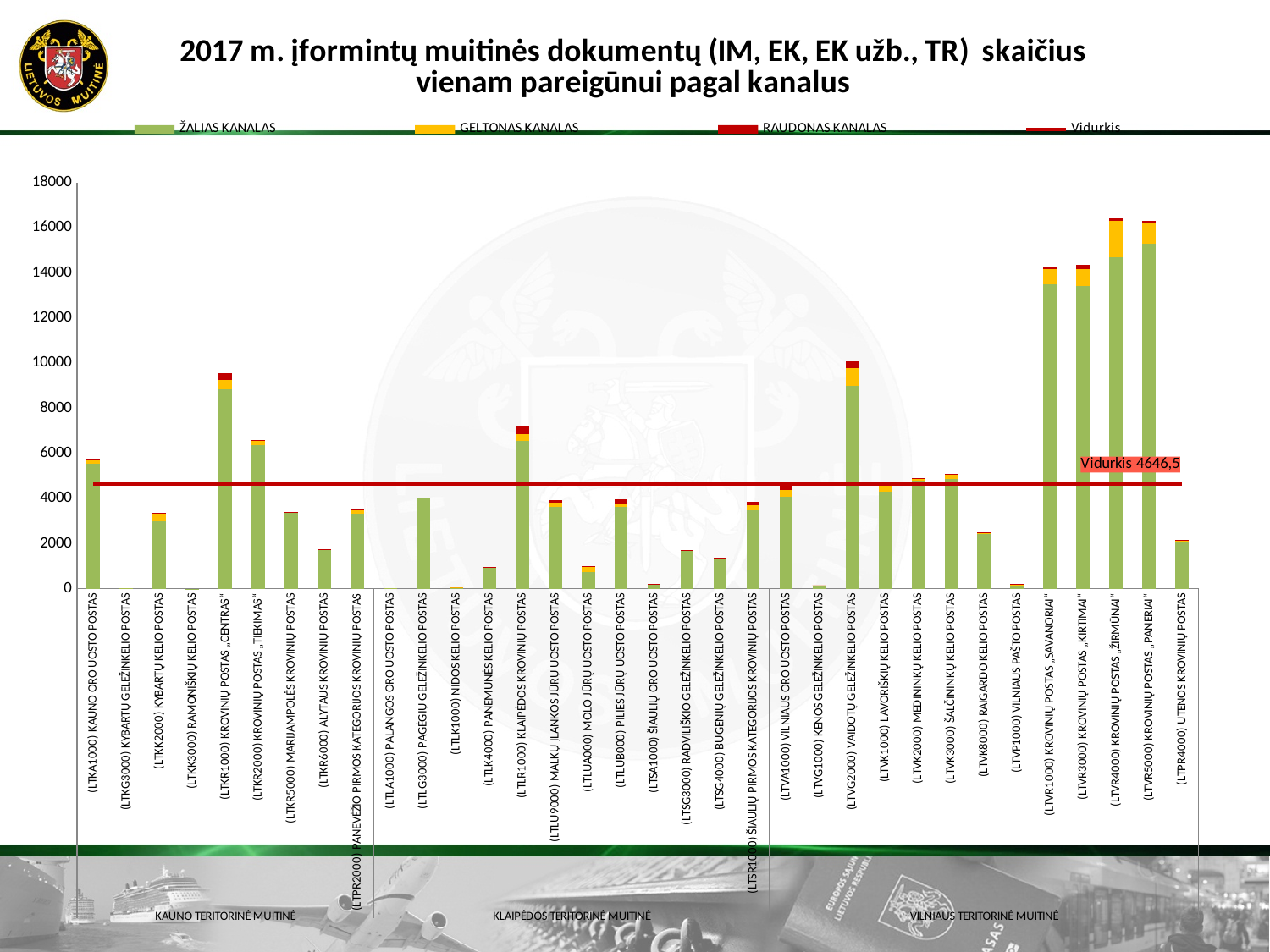
Which has the larger total: (LTVR4000) KROVINIŲ POSTAS „ŽIRMŪNAI“ or (LTVR1000) KROVINIŲ POSTAS „SAVANORIAI“? (LTVR4000) KROVINIŲ POSTAS „ŽIRMŪNAI“ Is the total value for (LTSG4000) BUGENIŲ GELEŽINKELIO POSTAS greater or less than 2000? less What is the title of the chart on the slide? 2017 m. įformintų muitinės dokumentų (IM, EK, EK užb., TR) skaičius vienam pareigūnui pagal kanalus How many entries does the chart legend list? 4 Which has the larger total: (LTKR1000) KROVINIŲ POSTAS „CENTRAS“ or (LTKR2000) KROVINIŲ POSTAS „TIEKIMAS“? (LTKR1000) KROVINIŲ POSTAS „CENTRAS“ How many customs posts (categories) are shown along the x axis? 34 What kind of chart is shown on the slide? Stacked bar chart Which legend entry is represented by the green colour in the bars? ŽALIAS KANALAS Is the total value for (LTKA1000) KAUNO ORO UOSTO POSTAS greater or less than 4000? greater Is the total value for (LTVG2000) VAIDOTŲ GELEŽINKELIO POSTAS greater or less than 8000? greater What is the value of the average (Vidurkis) line shown on the chart? 4646,5